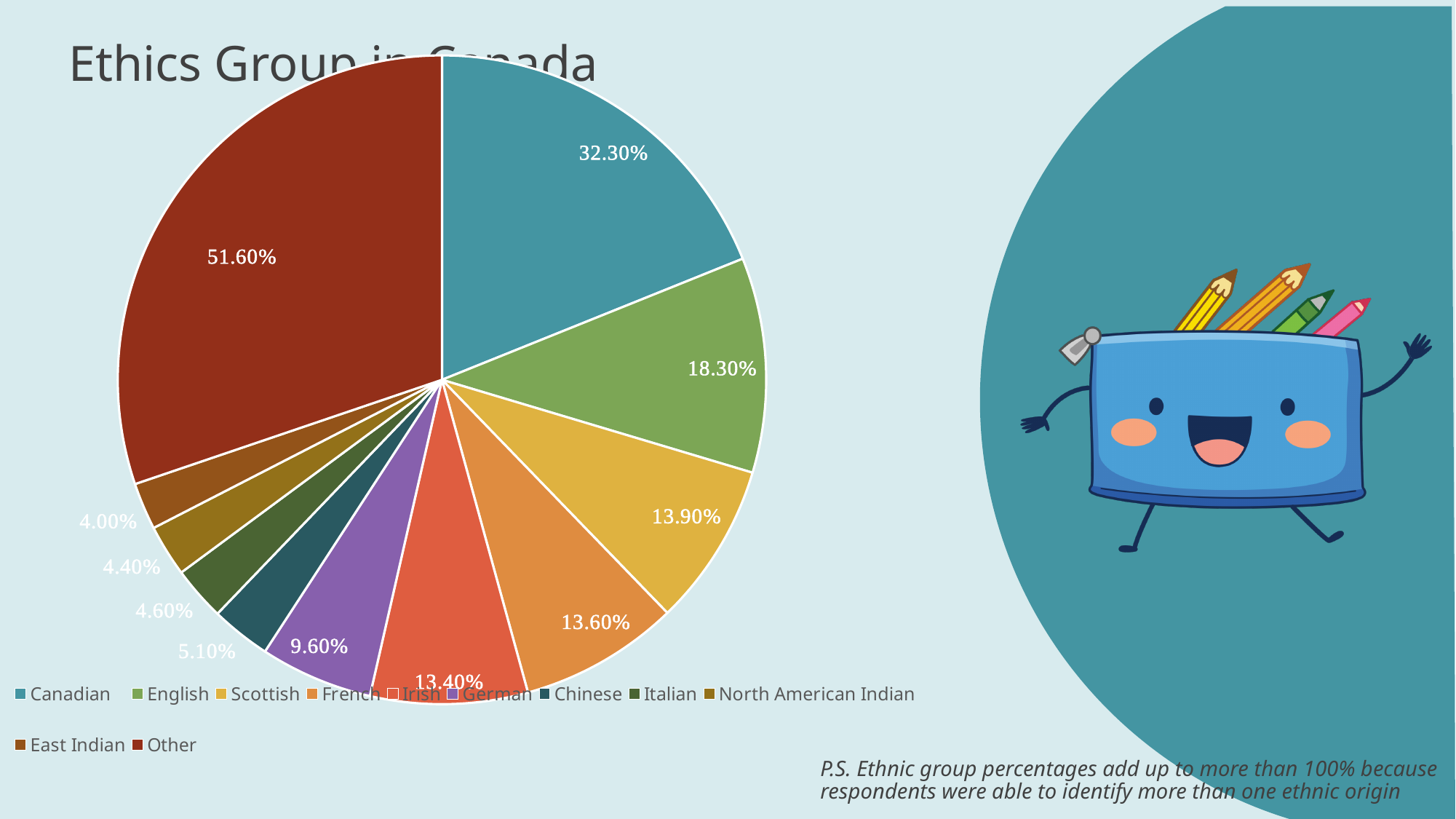
Which ethnic group has the smallest slice in the pie chart? East Indian What percentage is shown for the Canadian slice? 32.30% What percentage is shown for the Chinese slice? 5.10% What percentage is shown for the English slice? 18.30% What percentage is shown for the German slice? 9.60% What percentage is shown for the Italian slice? 4.60% Which is larger, the Scottish slice or the French slice? Scottish What colour is the Other slice in the pie chart? Dark red How many ethnic groups are shown in the pie chart? 11 What is the difference between the Canadian and English percentages? 14.00% What kind of chart is shown on the slide? Pie chart Which ethnic group has the largest slice in the pie chart? Other